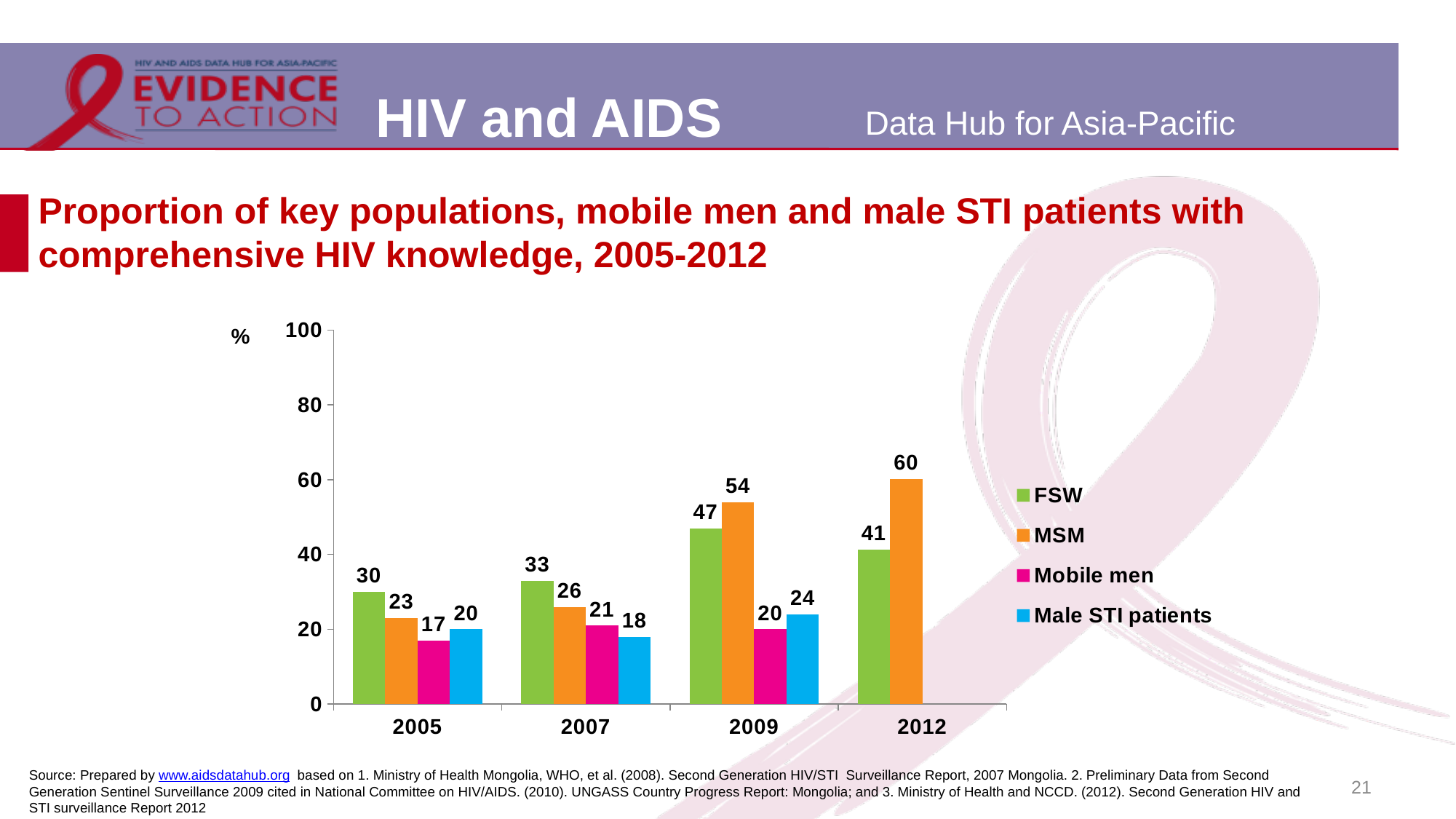
What is the value for MSM in 2012? 60 Is the value for FSW in 2012 greater or less than 40? greater What is the difference between the MSM and FSW values in 2009? 7 Which series has the lowest value in 2005? Mobile men In which year is the MSM value highest? 2012 How many years are shown on the x axis? 4 What is the value for FSW in 2005? 30 What kind of chart is shown on the slide? Bar chart What is the value for Male STI patients in 2009? 24 Which is larger in 2007: the FSW value or the MSM value? FSW What is the value for Mobile men in 2007? 21 How many series does the legend list? 4